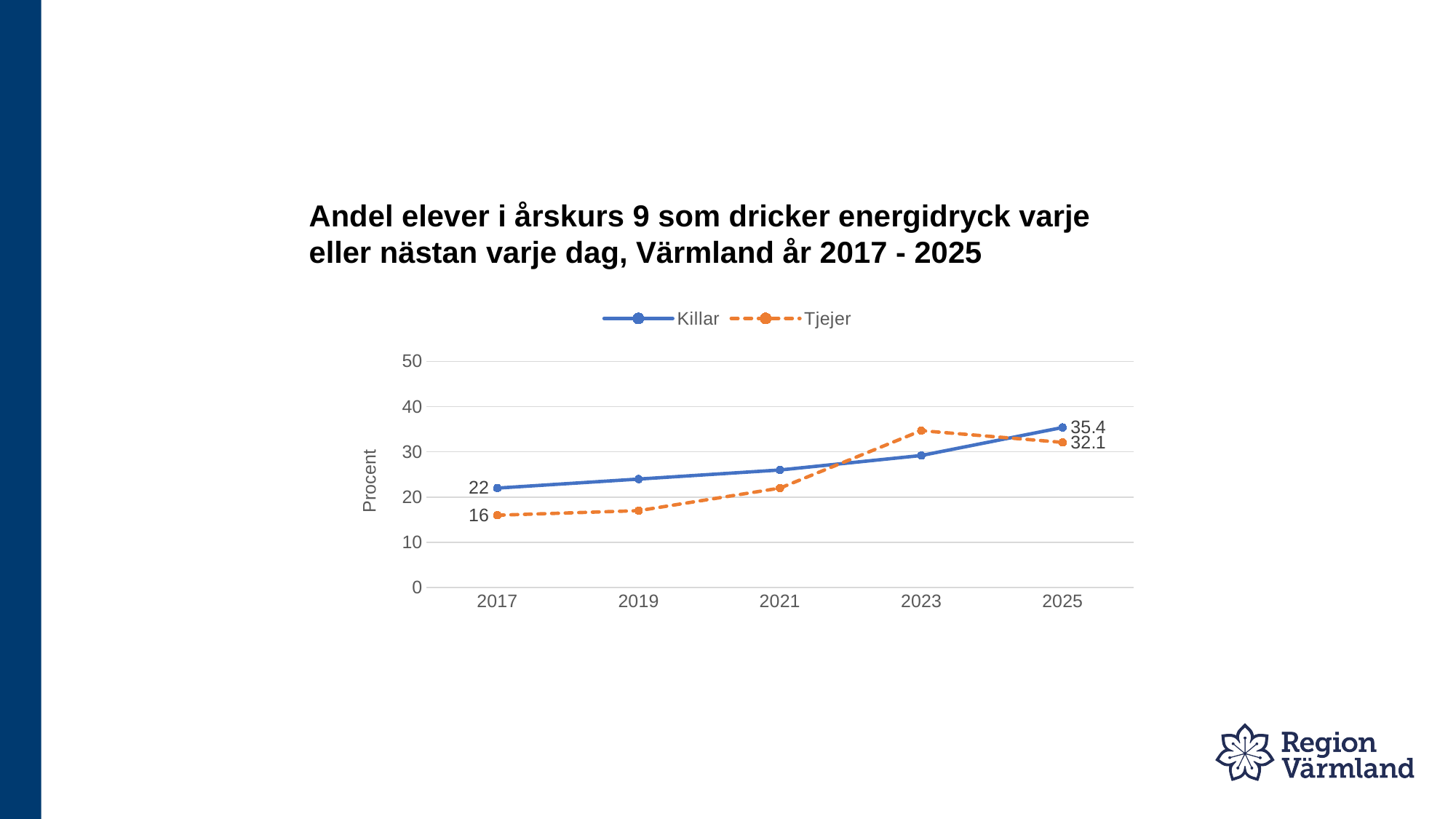
What kind of chart is shown on the slide? Line chart How many years are shown on the x axis? 5 By how much did the value for Killar increase from 2017 to 2025? 13.4 What is the difference between Killar and Tjejer in 2025? 3.3 What is the value for Tjejer in 2025? 32.1 What is the value for Tjejer in 2017? 16 Is the value for Tjejer in 2023 greater or less than 30? greater How many series does the legend list? 2 In 2023, which series has the higher value, Killar or Tjejer? Tjejer What is the value for Killar in 2025? 35.4 Is the value for Killar in 2021 greater or less than 30? less What is the value for Killar in 2017? 22